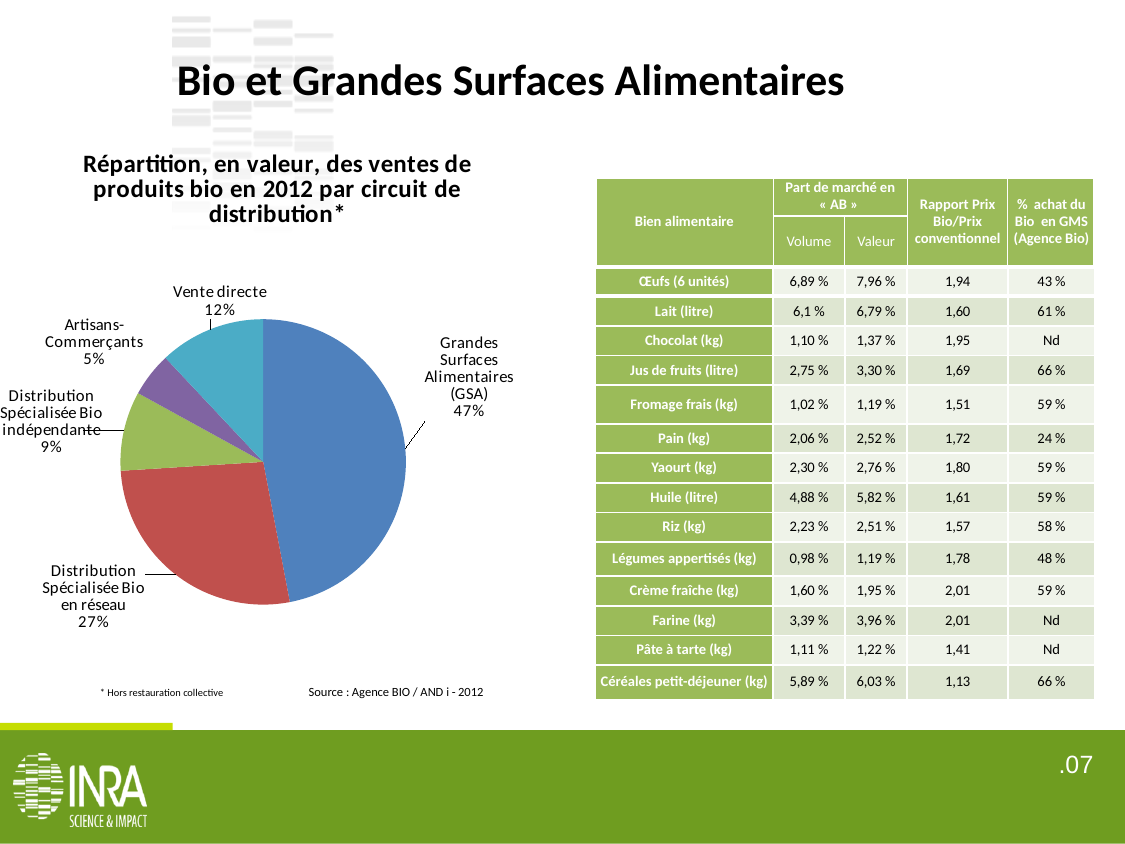
What share of the pie chart is Distribution Spécialisée Bio indépendante? 9% What share of the pie chart is Distribution Spécialisée Bio en réseau? 27% What share of the pie chart is Artisans-Commerçants? 5% What share of the pie chart is Grandes Surfaces Alimentaires (GSA)? 47% What is the title of the pie chart? Répartition, en valeur, des ventes de produits bio en 2012 par circuit de distribution* Which distribution channel has the largest slice of the pie chart? Grandes Surfaces Alimentaires (GSA) What is the difference in percentage points between Grandes Surfaces Alimentaires (GSA) and Distribution Spécialisée Bio en réseau? 20 percentage points What share of the pie chart is Vente directe? 12% Which is larger in the pie chart: Vente directe or Distribution Spécialisée Bio indépendante? Vente directe How many slices does the pie chart have? 5 Which distribution channel has the smallest slice of the pie chart? Artisans-Commerçants What type of chart is shown on the slide? Pie chart